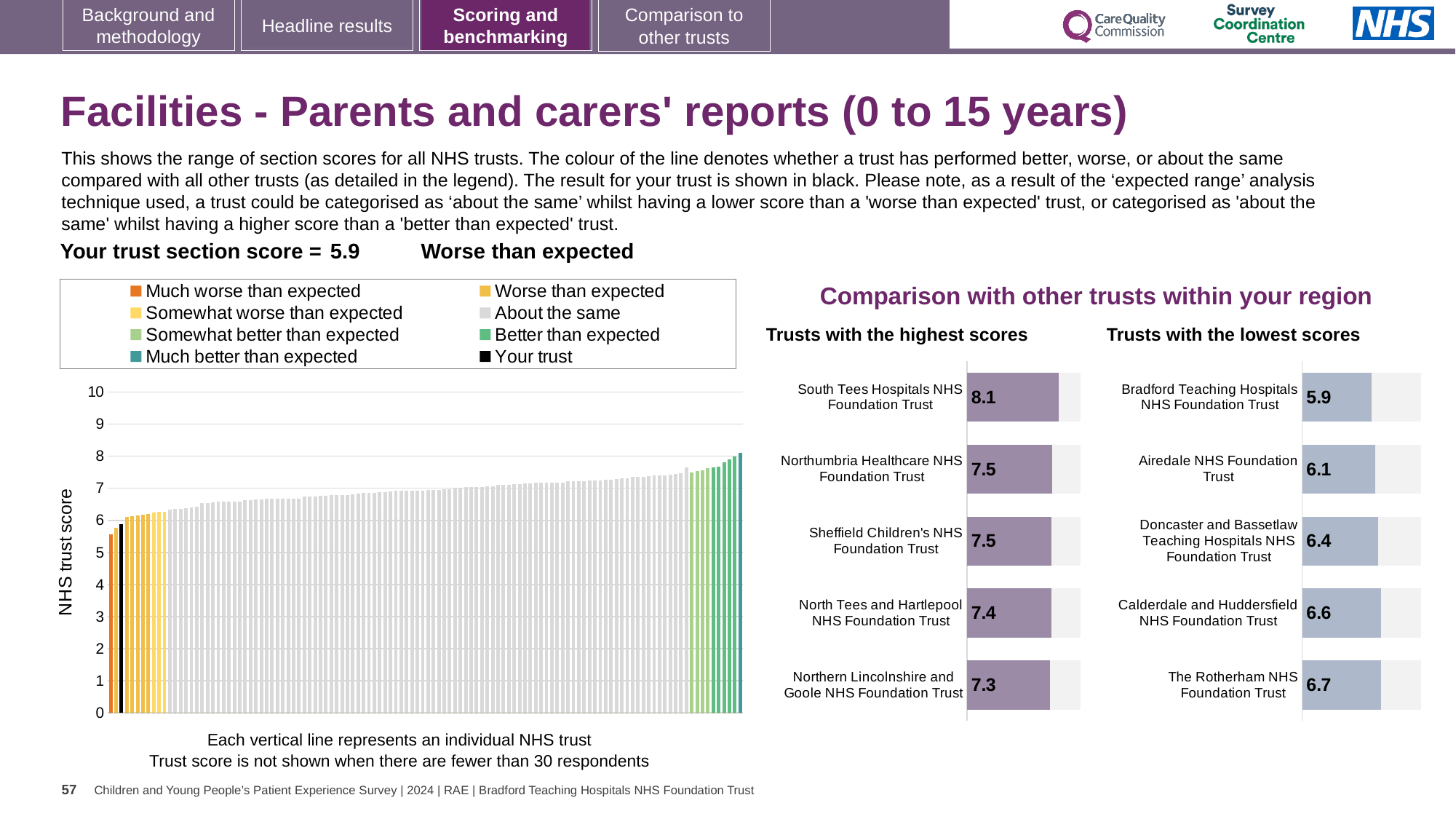
In the 'Trusts with the highest scores' chart, what is the score for South Tees Hospitals NHS Foundation Trust? 8.1 In the 'Trusts with the lowest scores' chart, what is the difference between the scores of The Rotherham NHS Foundation Trust and Airedale NHS Foundation Trust? 0.6 What kind of chart is the large chart on the left showing NHS trust scores? Bar chart In the large chart on the left, is the value of the leftmost (orange) bar greater or less than 6? less How many trusts are shown in the 'Trusts with the highest scores' chart? 5 In the 'Trusts with the lowest scores' chart, which trust has the lowest score? Bradford Teaching Hospitals NHS Foundation Trust In the 'Trusts with the highest scores' chart, which trust has the highest score? South Tees Hospitals NHS Foundation Trust In the 'Trusts with the lowest scores' chart, which has the larger score: Airedale NHS Foundation Trust or Calderdale and Huddersfield NHS Foundation Trust? Calderdale and Huddersfield NHS Foundation Trust In the 'Trusts with the highest scores' chart, what is the difference between the scores of South Tees Hospitals NHS Foundation Trust and Northern Lincolnshire and Goole NHS Foundation Trust? 0.8 In the large chart on the left, how many entries does the legend list? 8 In the 'Trusts with the lowest scores' chart, what is the score for Doncaster and Bassetlaw Teaching Hospitals NHS Foundation Trust? 6.4 In the large chart on the left, do the trust scores rise or fall from left to right? Rise